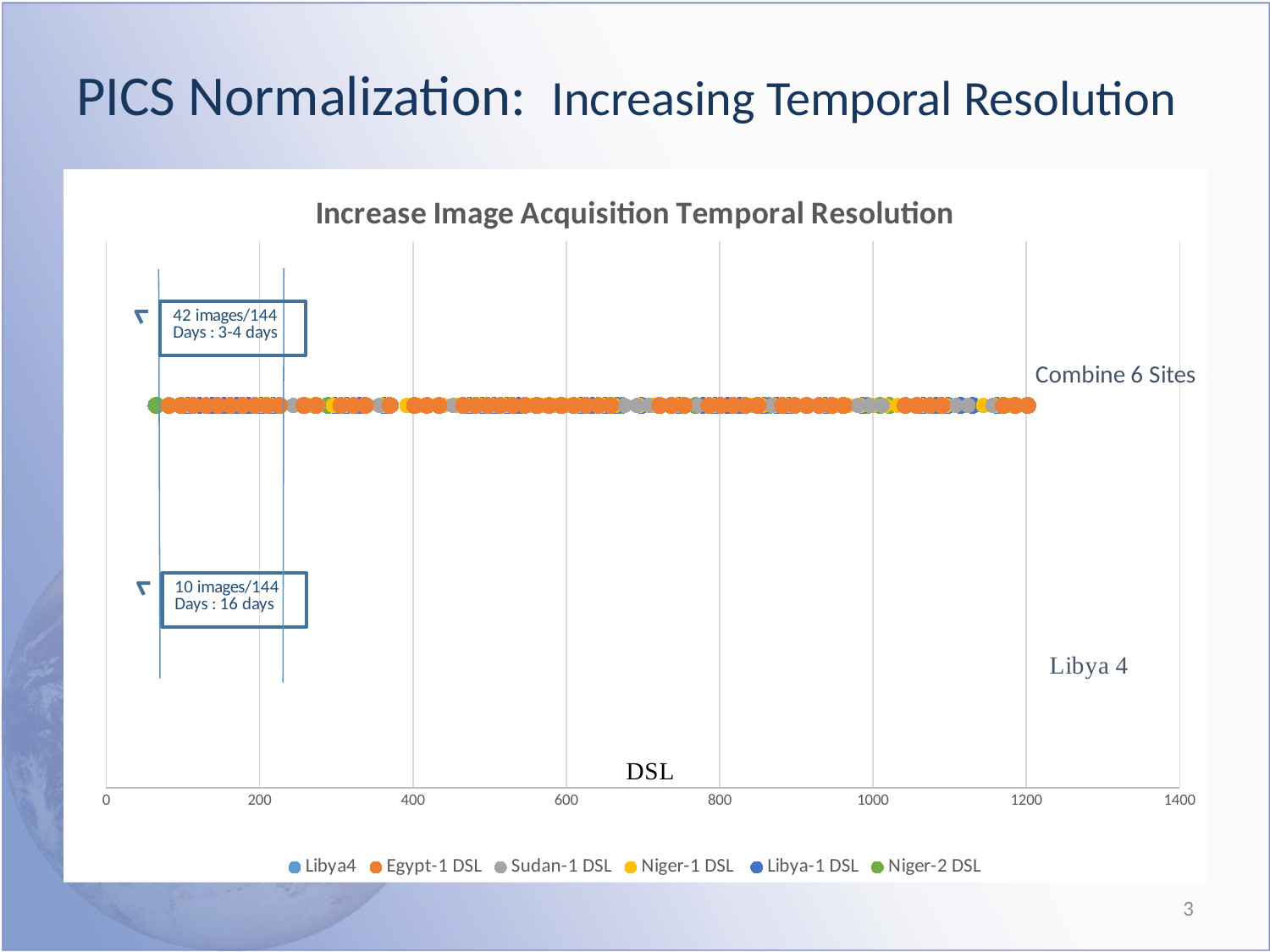
How many series does the chart legend list? 6 What temporal resolution in days is stated for the combined 6 sites? 3-4 days According to the annotation for Libya 4, how many images are acquired per 144 days? 10 images/144 Days What is the label on the x axis of the chart? DSL According to the annotation for the combined 6 sites, how many images are acquired per 144 days? 42 images/144 Days How many sites are combined in the upper row of points, according to the label on the chart? 6 How many more images per 144 days do the combined 6 sites provide than Libya 4? 32 What kind of chart is shown on the slide? scatter chart What temporal resolution in days is stated for Libya 4? 16 days Which has more images per 144 days, the combined 6 sites or Libya 4? Combine 6 Sites What is the title of the chart? Increase Image Acquisition Temporal Resolution